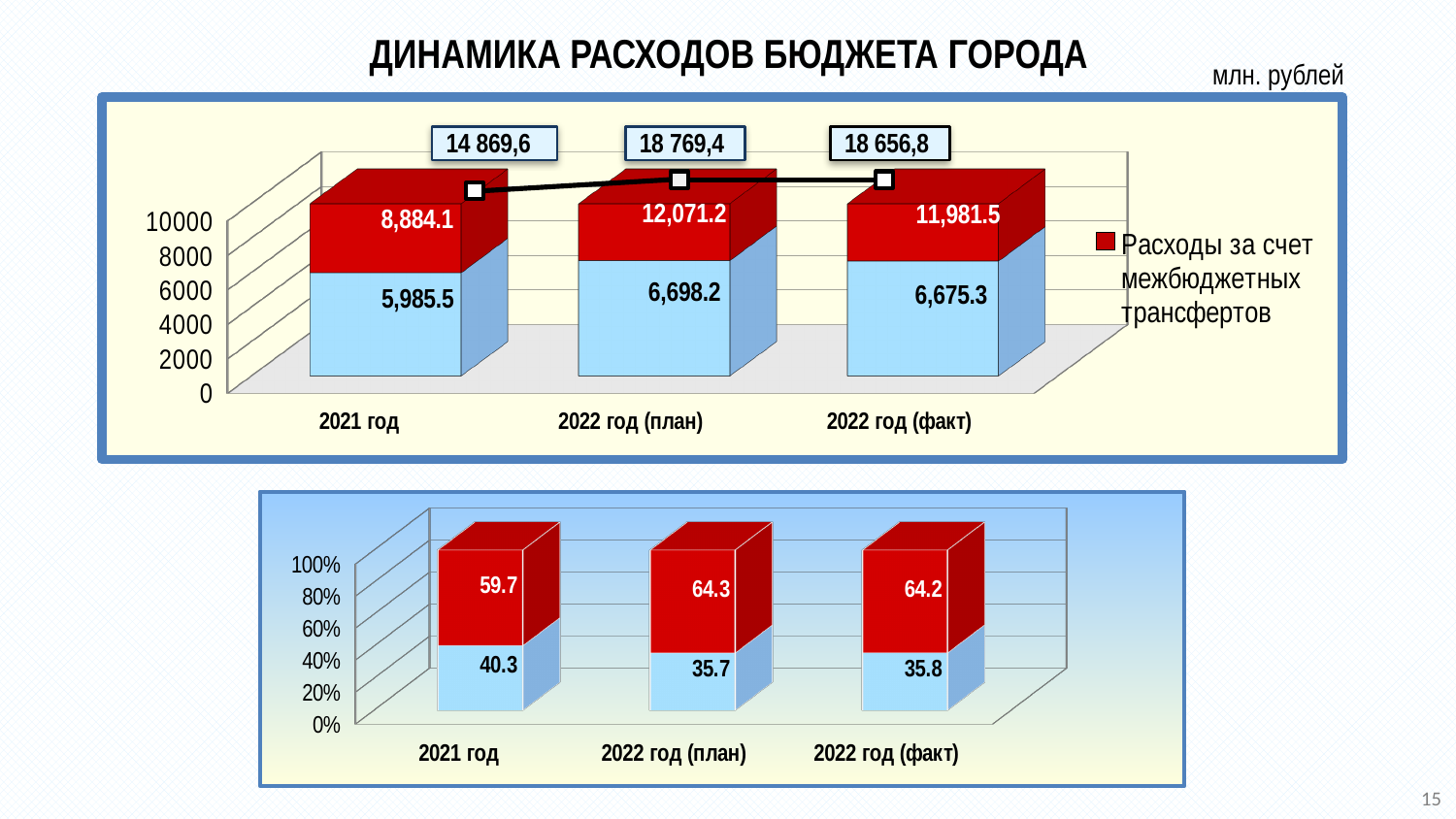
In the top chart, is the light blue segment larger for 2021 год or for 2022 год (факт)? 2022 год (факт) In the top chart, what is the value of the red segment (Расходы за счет межбюджетных трансфертов) for 2021 год? 8,884.1 In the top chart, what total is shown above the bar for 2022 год (факт)? 18 656,8 In the bottom chart, what is the value of the light blue segment for 2021 год? 40.3 How many categories are shown on the x axis of the top chart? 3 In the top chart, which category has the highest total? 2022 год (план) In the top chart, what is the difference between the red segment values for 2022 год (план) and 2022 год (факт)? 89.7 In the bottom chart, what is the value of the red segment for 2022 год (план)? 64.3 What kind of chart is the bottom chart? Stacked bar chart In the top chart, what is the value of the light blue segment for 2022 год (план)? 6,698.2 What is the title of the slide's top chart? ДИНАМИКА РАСХОДОВ БЮДЖЕТА ГОРОДА In the top chart, which category has the lowest value for the red segment? 2021 год